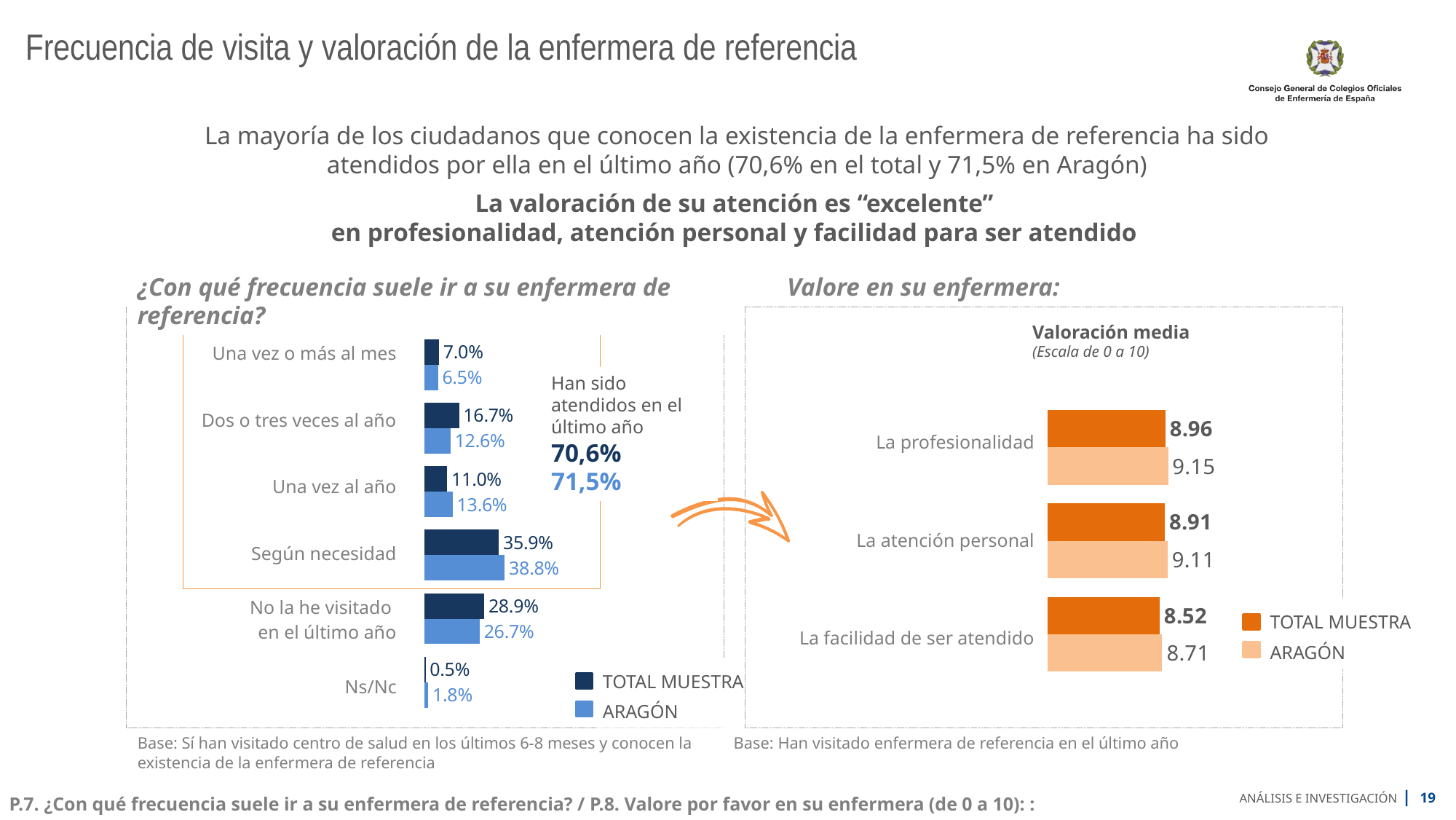
In the right chart (Valore en su enfermera), how many series does the legend list? 2 In the left chart (¿Con qué frecuencia suele ir a su enfermera de referencia?), what is the TOTAL MUESTRA value for 'Según necesidad'? 35.9% In the left chart (¿Con qué frecuencia suele ir a su enfermera de referencia?), which category has the highest ARAGÓN value? Según necesidad In the left chart (¿Con qué frecuencia suele ir a su enfermera de referencia?), what is the ARAGÓN value for 'Dos o tres veces al año'? 12.6% In the left chart (¿Con qué frecuencia suele ir a su enfermera de referencia?), which is larger for 'Una vez al año': TOTAL MUESTRA or ARAGÓN? ARAGÓN In the right chart (Valore en su enfermera), which item has the lowest ARAGÓN score? La facilidad de ser atendido In the left chart (¿Con qué frecuencia suele ir a su enfermera de referencia?), which category has the lowest TOTAL MUESTRA value? Ns/Nc In the right chart (Valore en su enfermera), what is the difference between the ARAGÓN and TOTAL MUESTRA scores for 'La atención personal'? 0.20 In the left chart (¿Con qué frecuencia suele ir a su enfermera de referencia?), how many categories are shown? 6 In the right chart (Valore en su enfermera), what is the ARAGÓN score for 'La profesionalidad'? 9.15 In the right chart (Valore en su enfermera), what is the TOTAL MUESTRA score for 'La facilidad de ser atendido'? 8.52 In the left chart (¿Con qué frecuencia suele ir a su enfermera de referencia?), what is the difference between the TOTAL MUESTRA and ARAGÓN values for 'No la he visitado en el último año'? 2.2%